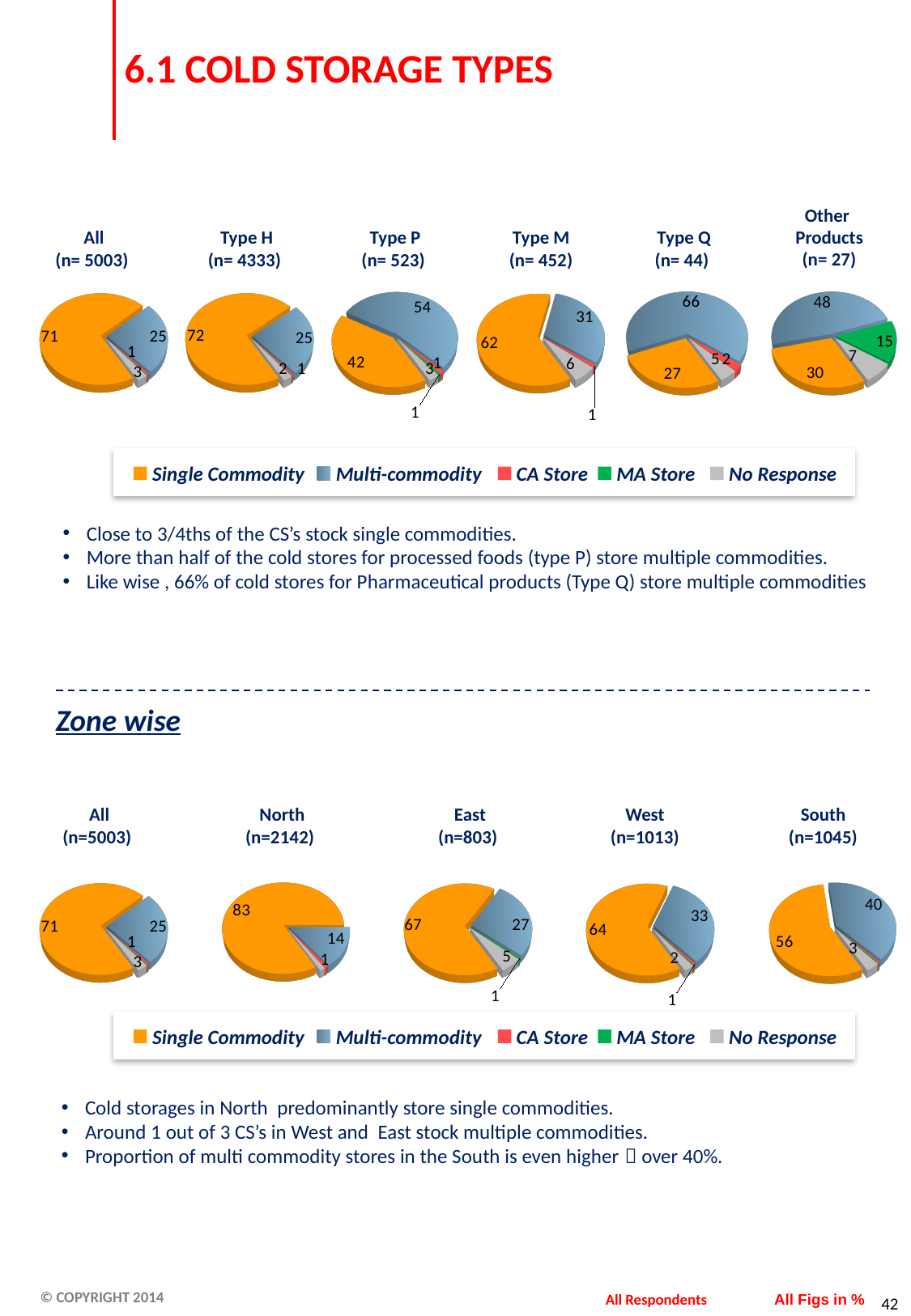
In the Zone wise row, what share of the North (n=2142) pie is Multi-commodity? 14 What kind of chart is used for the All (n= 5003) data in the top row? Pie chart In the Zone wise row, which zone has the largest Multi-commodity share? South In the top row, what share of the Type Q (n= 44) pie is Single Commodity? 27 In the Zone wise row, what is the difference between the Multi-commodity shares of West (n=1013) and East (n=803)? 6 How many series does the legend below the top row of pies list? 5 In the top row, which is larger in the Type H (n= 4333) pie: Single Commodity or Multi-commodity? Single Commodity In the top row, what share of the Type P (n= 523) pie is Multi-commodity? 54 In the Zone wise row, what share of the South (n=1045) pie is Single Commodity? 56 In the top row, what share of the Other Products (n= 27) pie is MA Store? 15 In the Zone wise row, which zone has the largest Single Commodity share? North In the top row, what share of the Type M (n= 452) pie is Single Commodity? 62